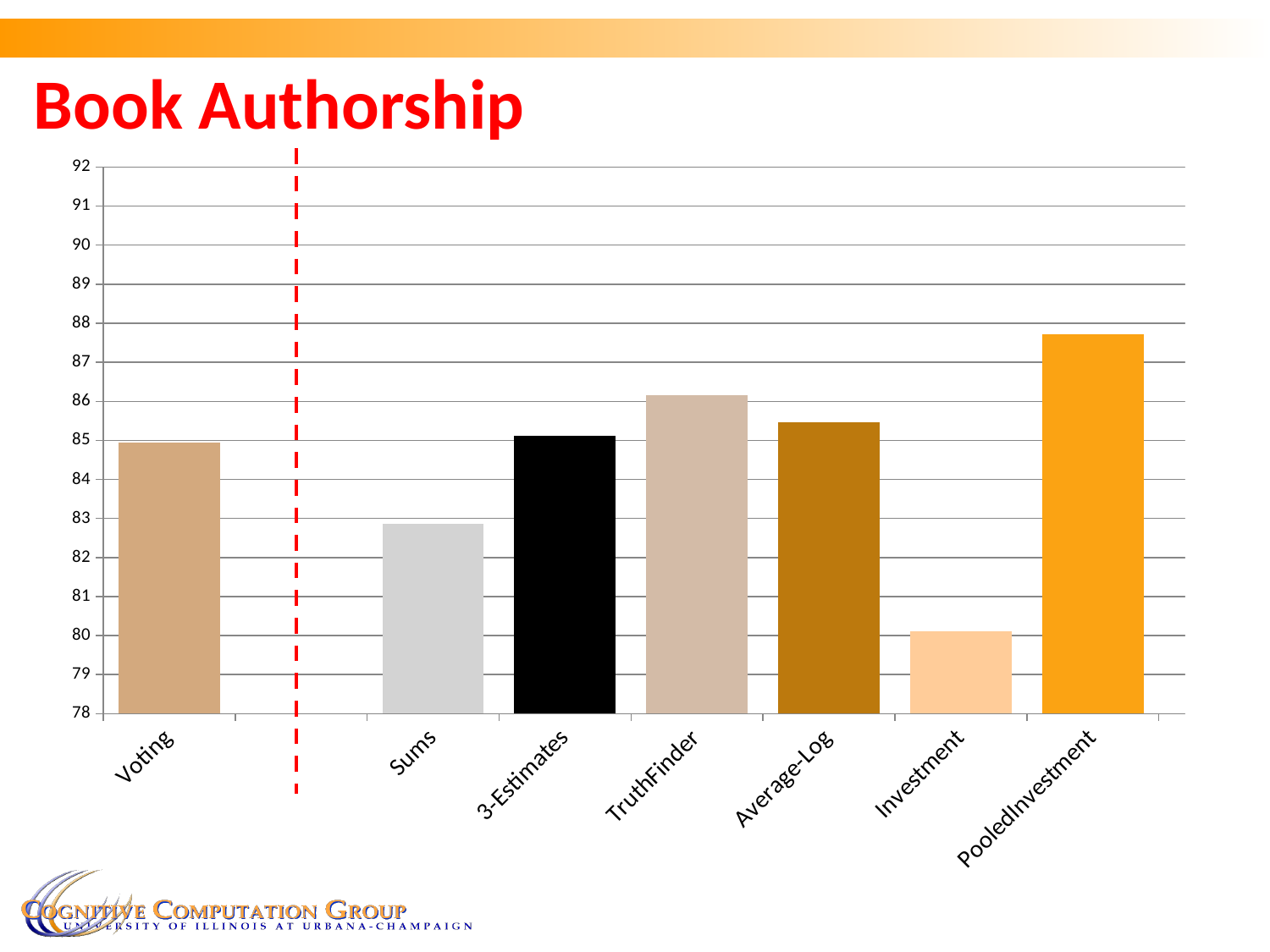
Is the value for Sums greater or less than 84? less Is the value for TruthFinder greater or less than 85? greater What is the title of the slide containing the chart? Book Authorship Which is larger, the value for Sums or the value for Investment? Sums Is the value for PooledInvestment greater or less than 87? greater Which is larger, the value for TruthFinder or the value for PooledInvestment? PooledInvestment Which category has the lowest bar? Investment How many categories are plotted on the x axis? 7 Which category has the highest bar? PooledInvestment What kind of chart is shown on the slide? bar chart